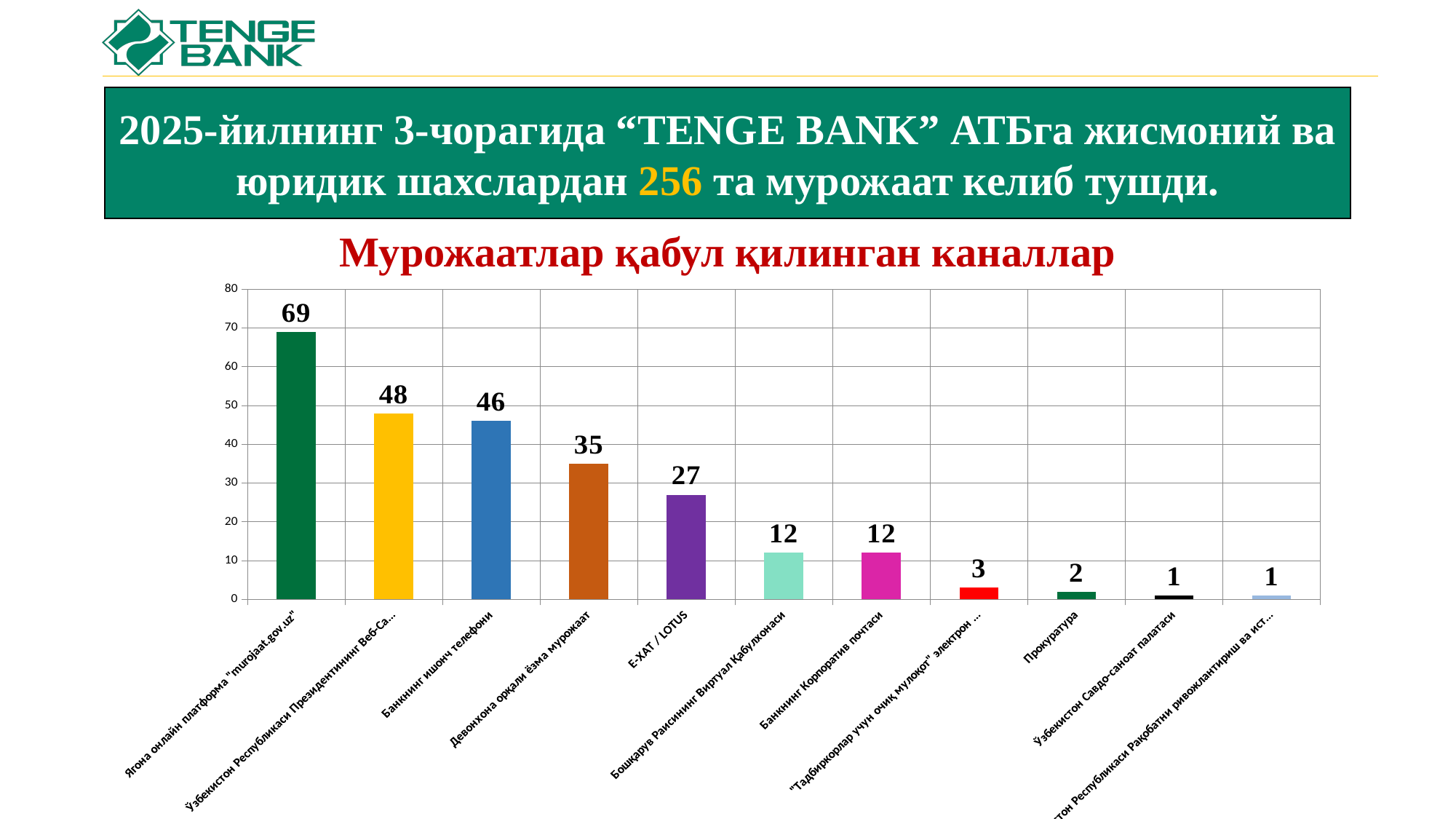
What is the difference between the values for Банкнинг ишонч телефони and E-XAT / LOTUS? 19 What is the value for Банкнинг ишонч телефони? 46 What type of chart is shown on the slide? bar chart What is the value for Девонхона орқали ёзма мурожаат? 35 What is the value for Ягона онлайн платформа "murojaat.gov.uz"? 69 How many bars (categories) does the chart show? 11 What is the title of the chart? Мурожаатлар қабул қилинган каналлар Do the bar values generally rise or fall from left to right along the x axis? fall What is the value for Прокуратура? 2 Which is larger: the value for Девонхона орқали ёзма мурожаат or the value for Банкнинг Корпоратив почтаси? Девонхона орқали ёзма мурожаат Which category has the highest value? Ягона онлайн платформа "murojaat.gov.uz" What is the value for E-XAT / LOTUS? 27